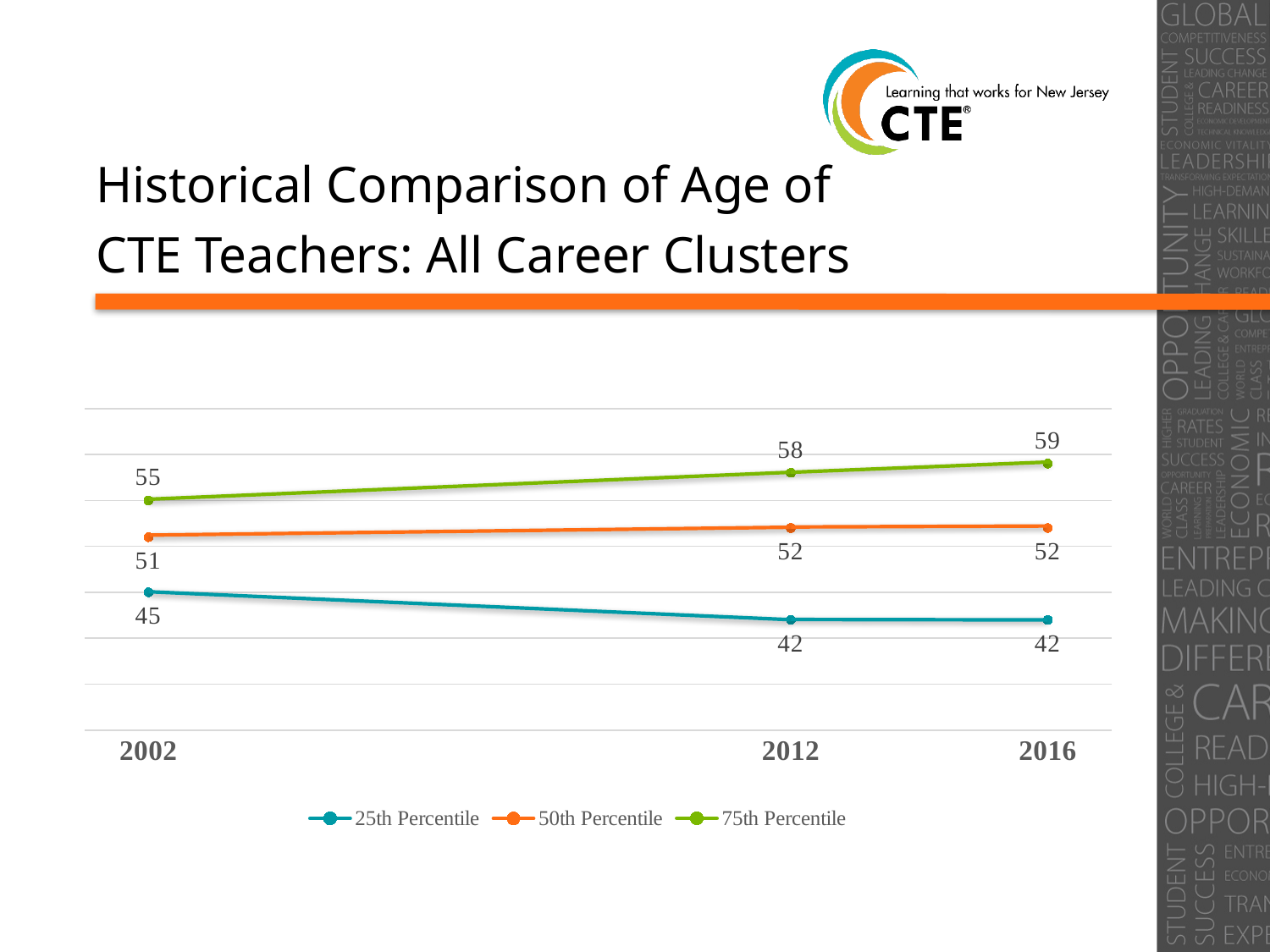
In which year is the 75th Percentile value highest? 2016 What is the difference between the 75th Percentile and 25th Percentile values in 2016? 17 What is the 75th Percentile value in 2002? 55 What is the 75th Percentile value in 2016? 59 What is the 25th Percentile value in 2012? 42 Does the 25th Percentile line rise or fall from 2002 to 2012? Fall In which year is the 25th Percentile value highest? 2002 How many years are shown on the x axis? 3 What kind of chart is shown on the slide? Line chart What is the 50th Percentile value in 2016? 52 How many series does the legend list? 3 By how much did the 75th Percentile value change from 2002 to 2012? 3